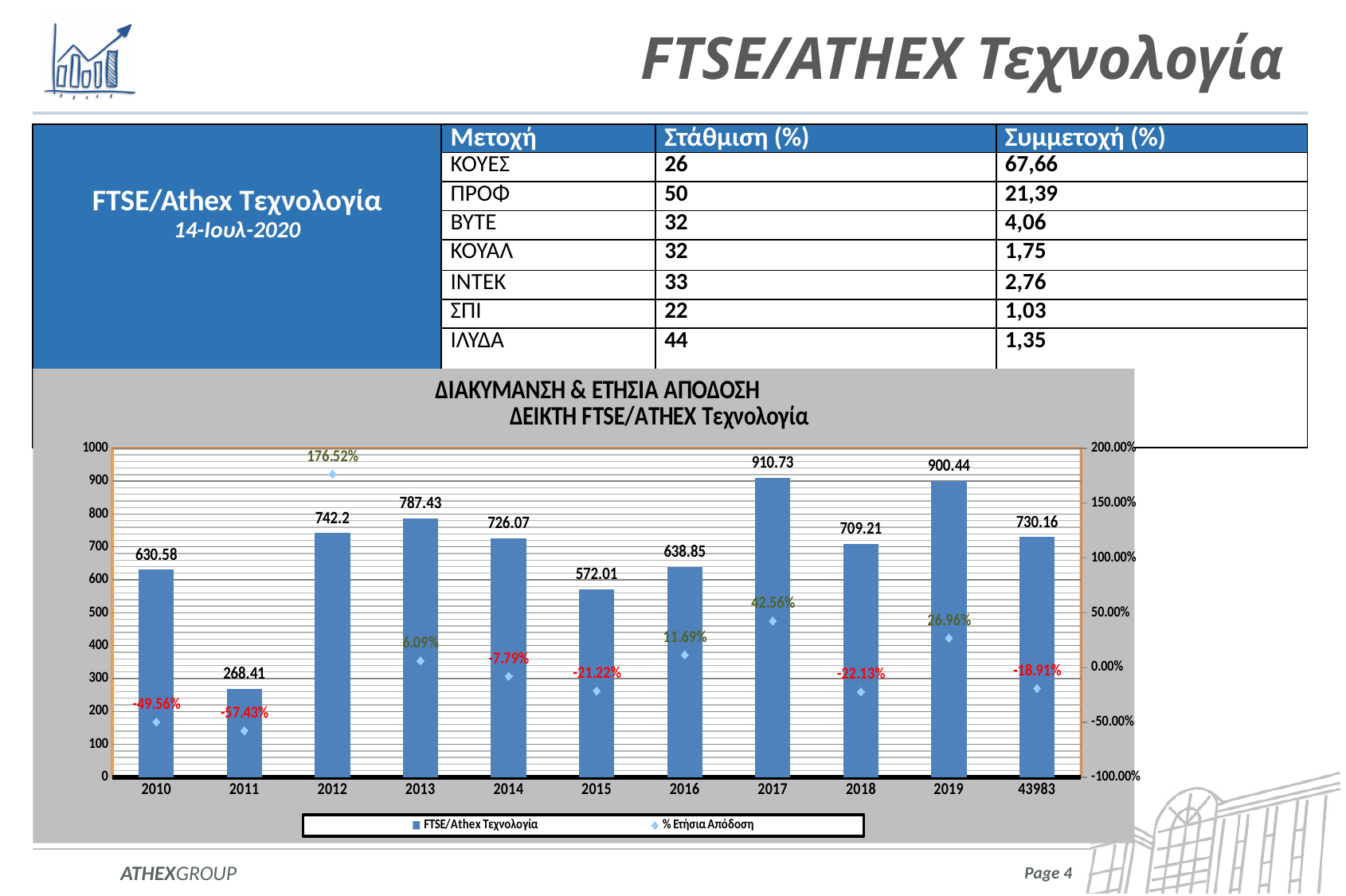
How many categories are shown on the x axis of the chart? 11 What is the value of the FTSE/Athex Τεχνολογία bar for 2017? 910.73 Which year has the highest FTSE/Athex Τεχνολογία bar value? 2017 Which year has the lowest FTSE/Athex Τεχνολογία bar value? 2011 What is the difference between the FTSE/Athex Τεχνολογία bar values for 2017 and 2019? 10.29 What is the value of the FTSE/Athex Τεχνολογία bar for 2011? 268.41 What is the % Ετήσια Απόδοση value shown for 2012? 176.52% What is the % Ετήσια Απόδοση value shown for 2018? -22.13% Which year has the lowest % Ετήσια Απόδοση value? 2011 How many series does the chart legend list? 2 Which is larger, the FTSE/Athex Τεχνολογία bar value for 2013 or for 2014? 2013 Does the FTSE/Athex Τεχνολογία bar value rise or fall from 2010 to 2011? fall